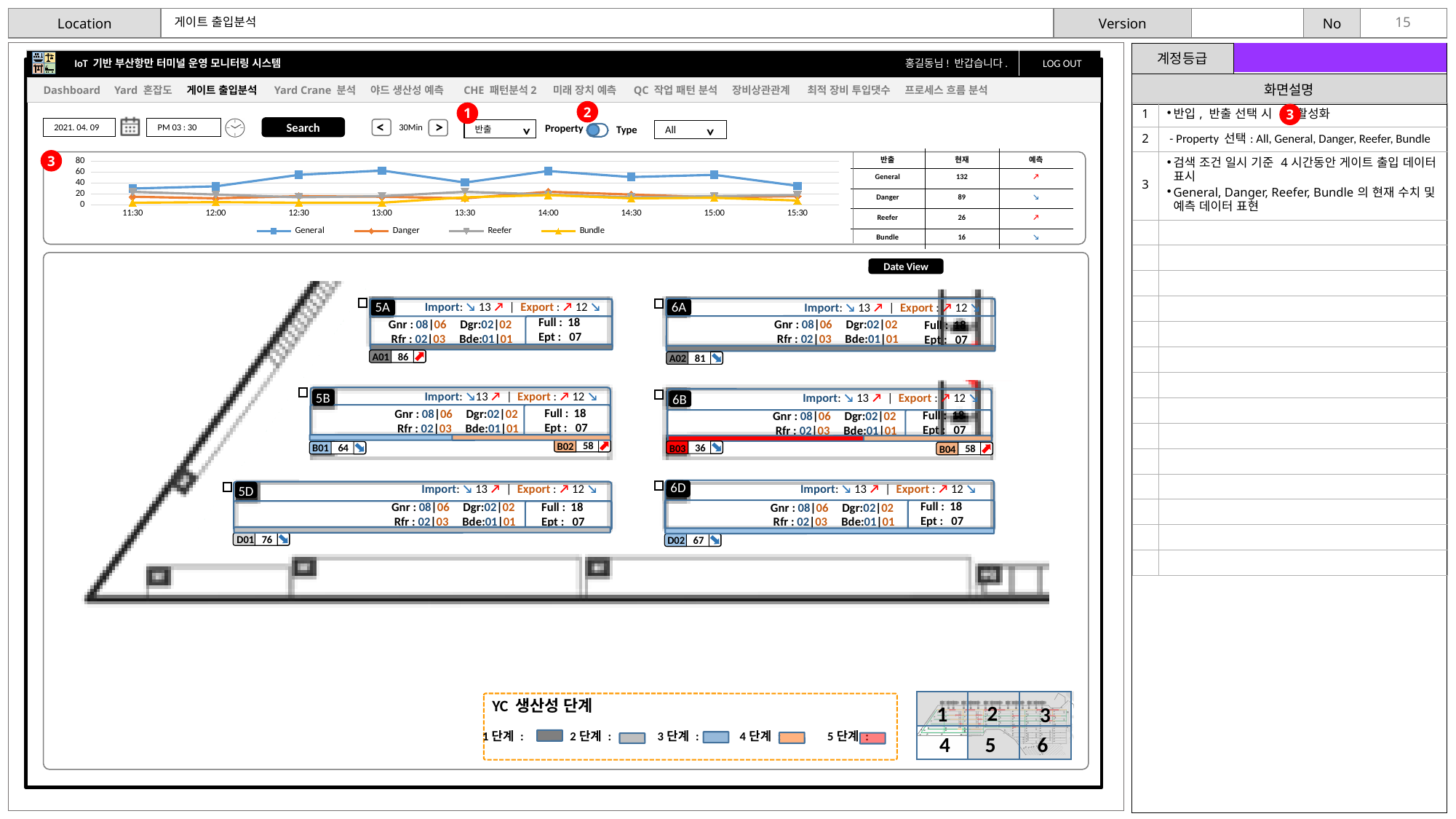
At 13:00, which is larger in the line chart: General or Bundle? General How many series does the legend of the line chart list? 4 What are the legend entries of the line chart, in order? General, Danger, Reefer, Bundle What is the highest tick value shown on the y axis of the line chart? 80 Is the value for General at 14:00 greater or less than 40? greater What kind of chart is shown at the top of the slide? line chart How many time points are plotted along the x axis of the line chart? 9 Is the value for Bundle at 13:00 greater or less than 20? less Is the value for General at 11:30 greater or less than 40? less Which series has the lowest value at 12:00 in the line chart? Bundle Does the General series rise or fall from 11:30 to 13:00? rise Which series has the highest value at 14:00 in the line chart? General